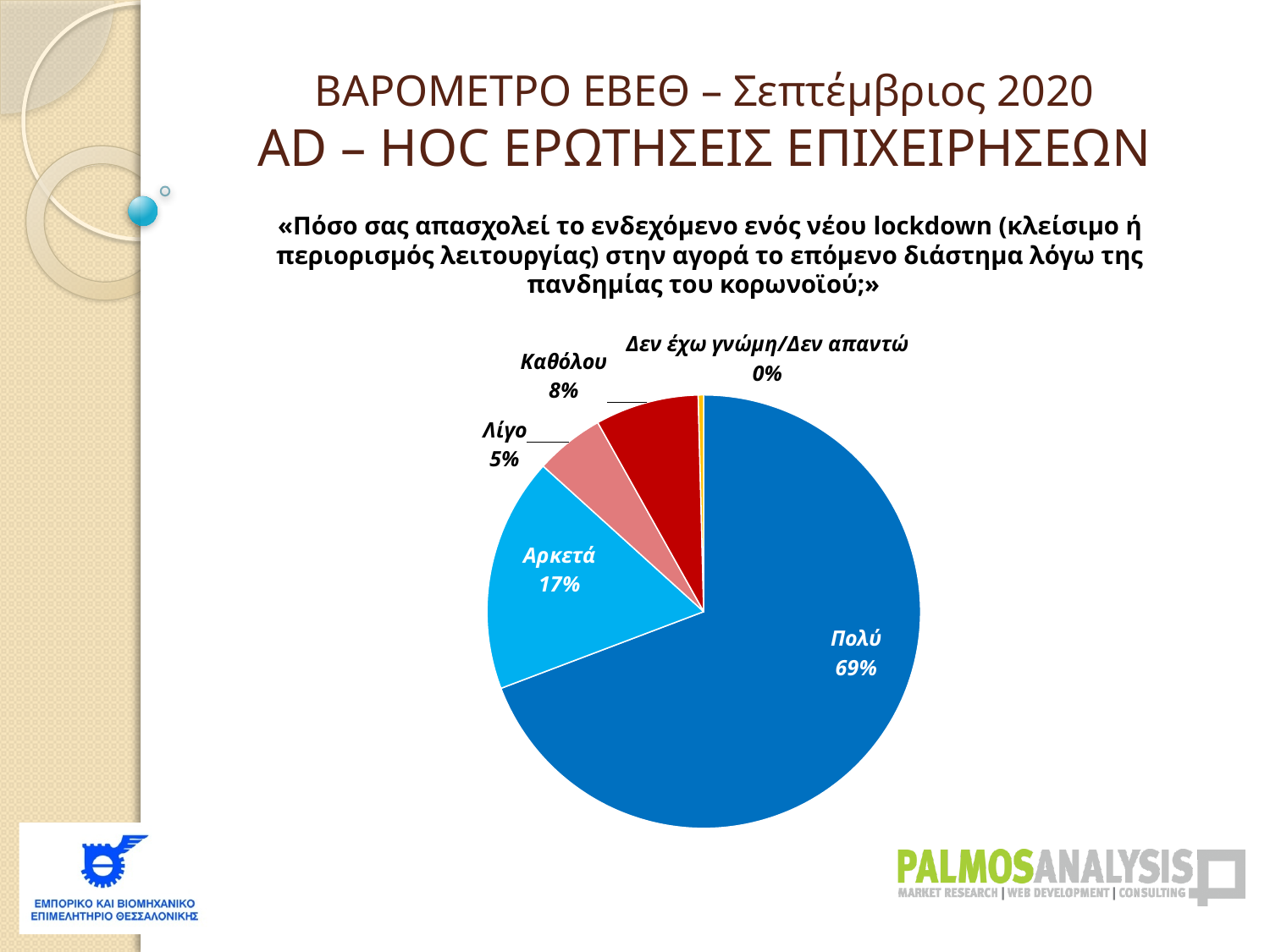
Which response category has the largest share of the pie? Πολύ What percentage of respondents answered "Λίγο"? 5% How many response categories are shown in the pie chart? 5 What percentage of respondents answered "Καθόλου"? 8% What percentage of respondents answered "Πολύ"? 69% What percentage is shown for "Δεν έχω γνώμη/Δεν απαντώ"? 0% What type of chart is shown on the slide? pie chart What percentage of respondents answered "Αρκετά"? 17% What is the difference in percentage points between "Πολύ" and "Αρκετά"? 52 Which is larger, the share for "Καθόλου" or the share for "Λίγο"? Καθόλου What colour is the slice for "Αρκετά"? light blue Which response category has the smallest share of the pie? Δεν έχω γνώμη/Δεν απαντώ